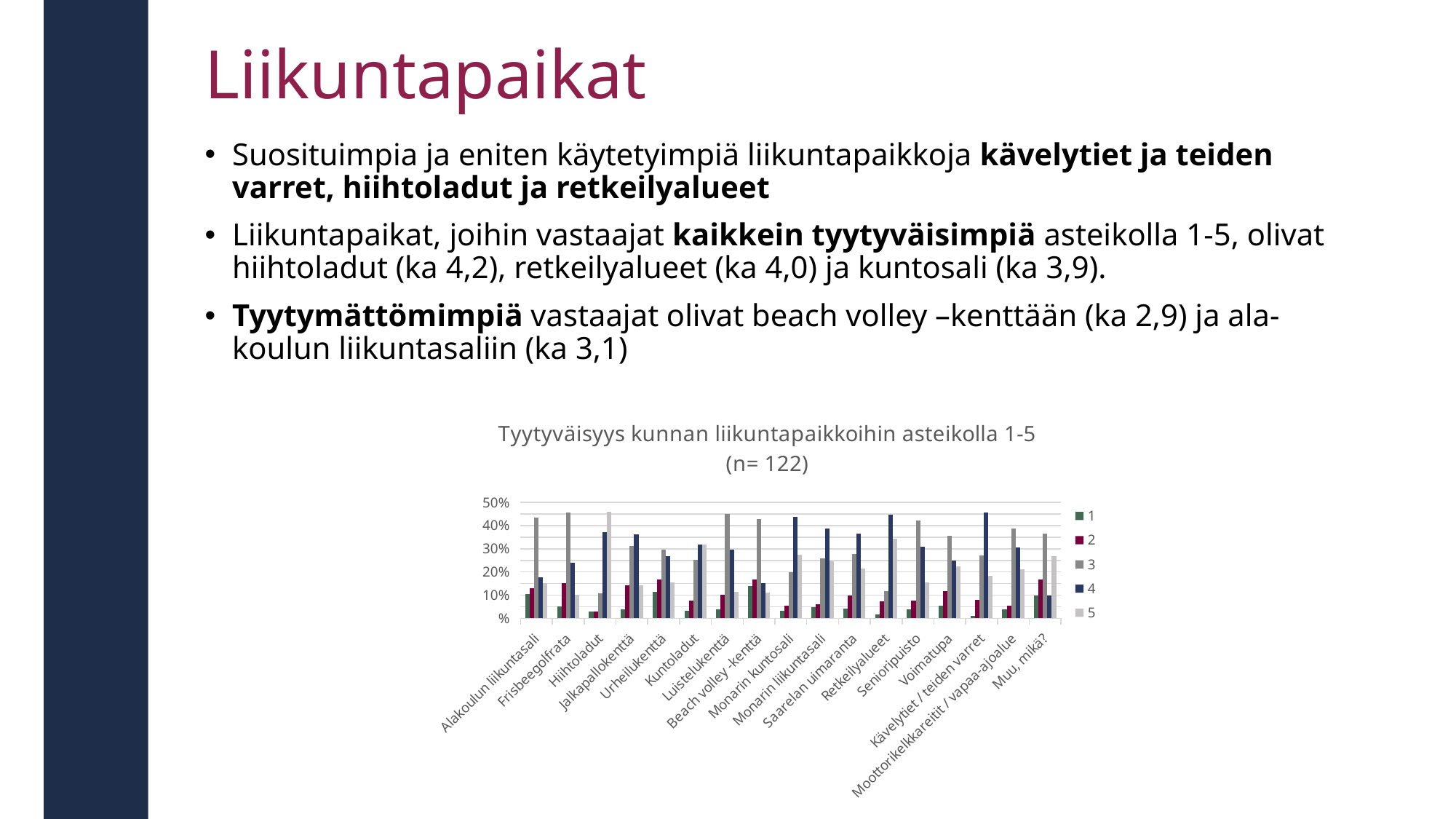
How many series does the legend of the chart list? 5 For Kävelytiet / teiden varret, which series has the larger value: series 3 or series 4? 4 Is the value of series 5 for Hiihtoladut greater or less than 40%? greater Is the value of series 4 for Kävelytiet / teiden varret greater or less than 40%? greater What is the title of the chart? Tyytyväisyys kunnan liikuntapaikkoihin asteikolla 1-5 (n= 122) What sample size (n) is given in the chart title? 122 Is the value of series 1 for Hiihtoladut greater or less than 10%? less What kind of chart is shown on the slide? bar chart How many categories are shown on the x axis of the chart? 17 For Hiihtoladut, which series has the larger value: series 1 or series 5? 5